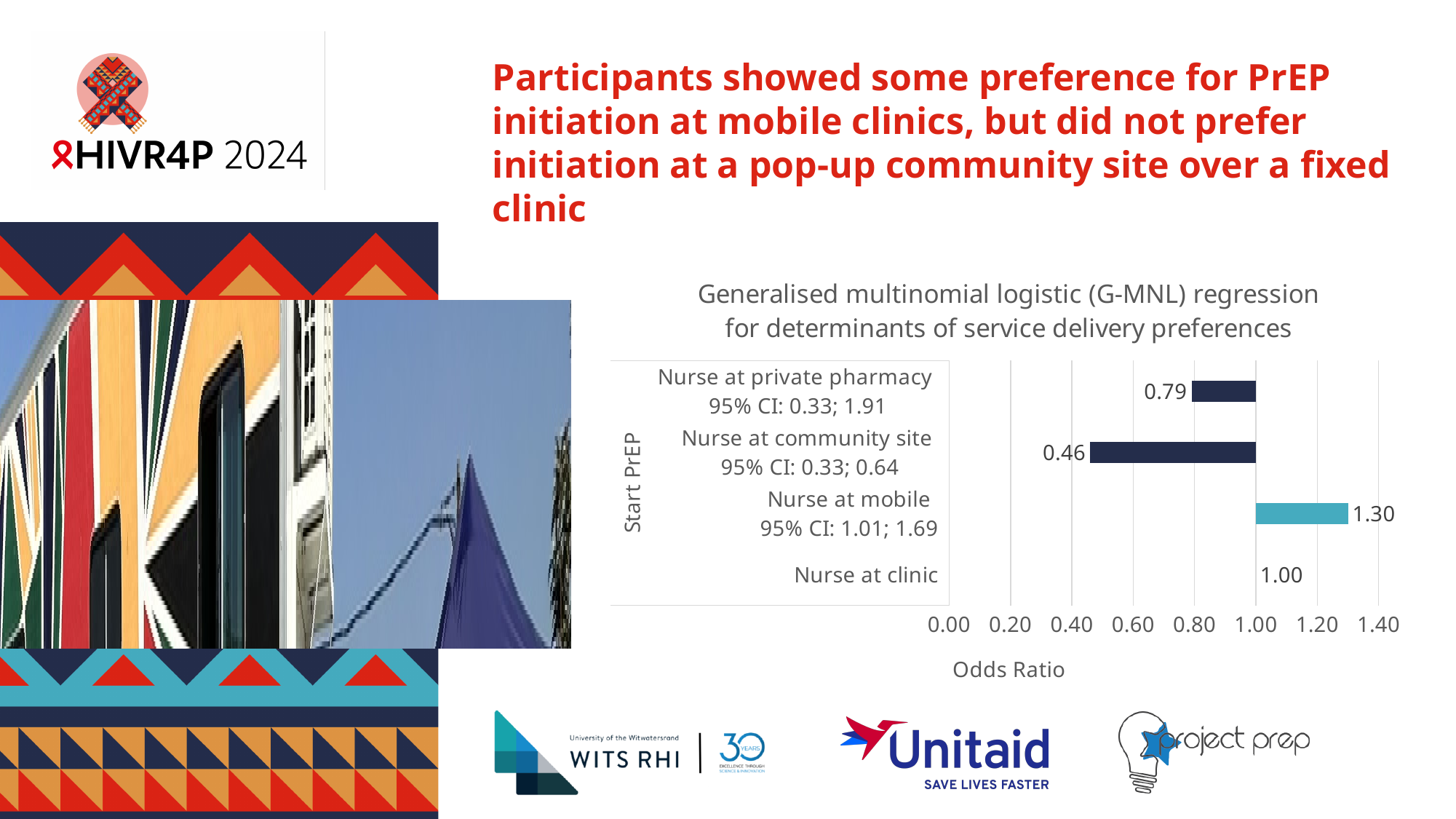
Which category has the lowest odds ratio? Nurse at community site What kind of chart is shown on the slide? Bar chart What is the odds ratio shown for Nurse at clinic? 1.00 Which has a larger odds ratio, Nurse at private pharmacy or Nurse at community site? Nurse at private pharmacy What is the odds ratio for Nurse at mobile? 1.30 What is the odds ratio for Nurse at community site? 0.46 How many categories are shown on the chart? 4 Which category has the highest odds ratio? Nurse at mobile What is the odds ratio for Nurse at private pharmacy? 0.79 What is the 95% confidence interval shown for Nurse at mobile? 1.01; 1.69 What is the difference between the odds ratios for Nurse at mobile and Nurse at community site? 0.84 What is the label of the horizontal axis of the chart? Odds Ratio